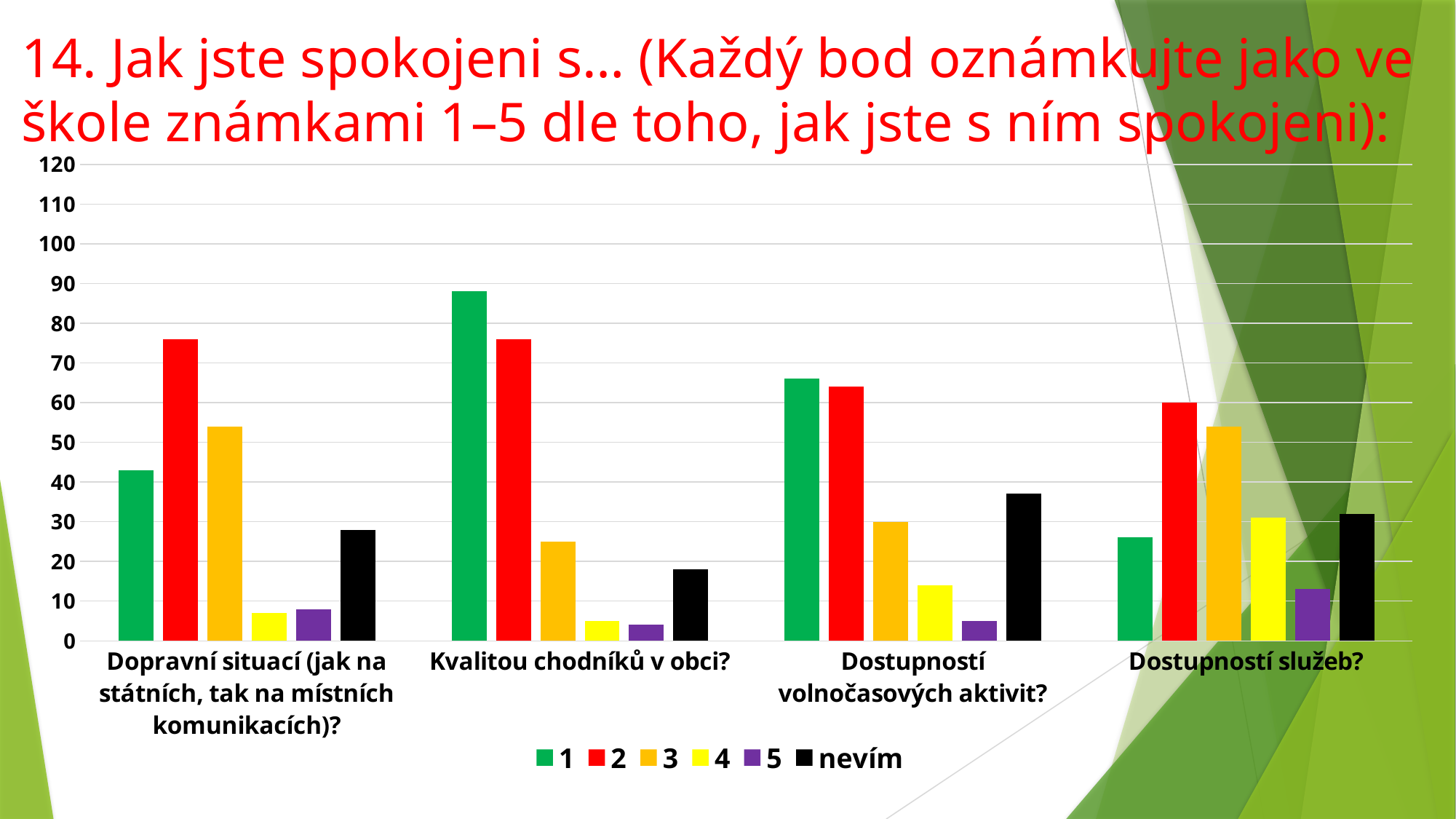
How many series does the legend list? 6 In "Kvalitou chodníků v obci?", which is larger: the bar for series "3" or the bar for series "nevím"? 3 Which category has the shortest bar for series "1"? Dostupností služeb? How many categories are shown on the x axis? 4 Is the value for series "nevím" in "Dostupností volnočasových aktivit?" greater or less than 30? greater Is the value for series "4" in "Kvalitou chodníků v obci?" greater or less than 10? less What colour represents the series "nevím" in the legend? black In "Dostupností služeb?", which is larger: the bar for series "1" or the bar for series "2"? 2 Is the value for series "1" in "Dopravní situací (jak na státních, tak na místních komunikacích)?" greater or less than 40? greater Which category has the tallest bar for series "1"? Kvalitou chodníků v obci? What kind of chart is shown on the slide? bar chart